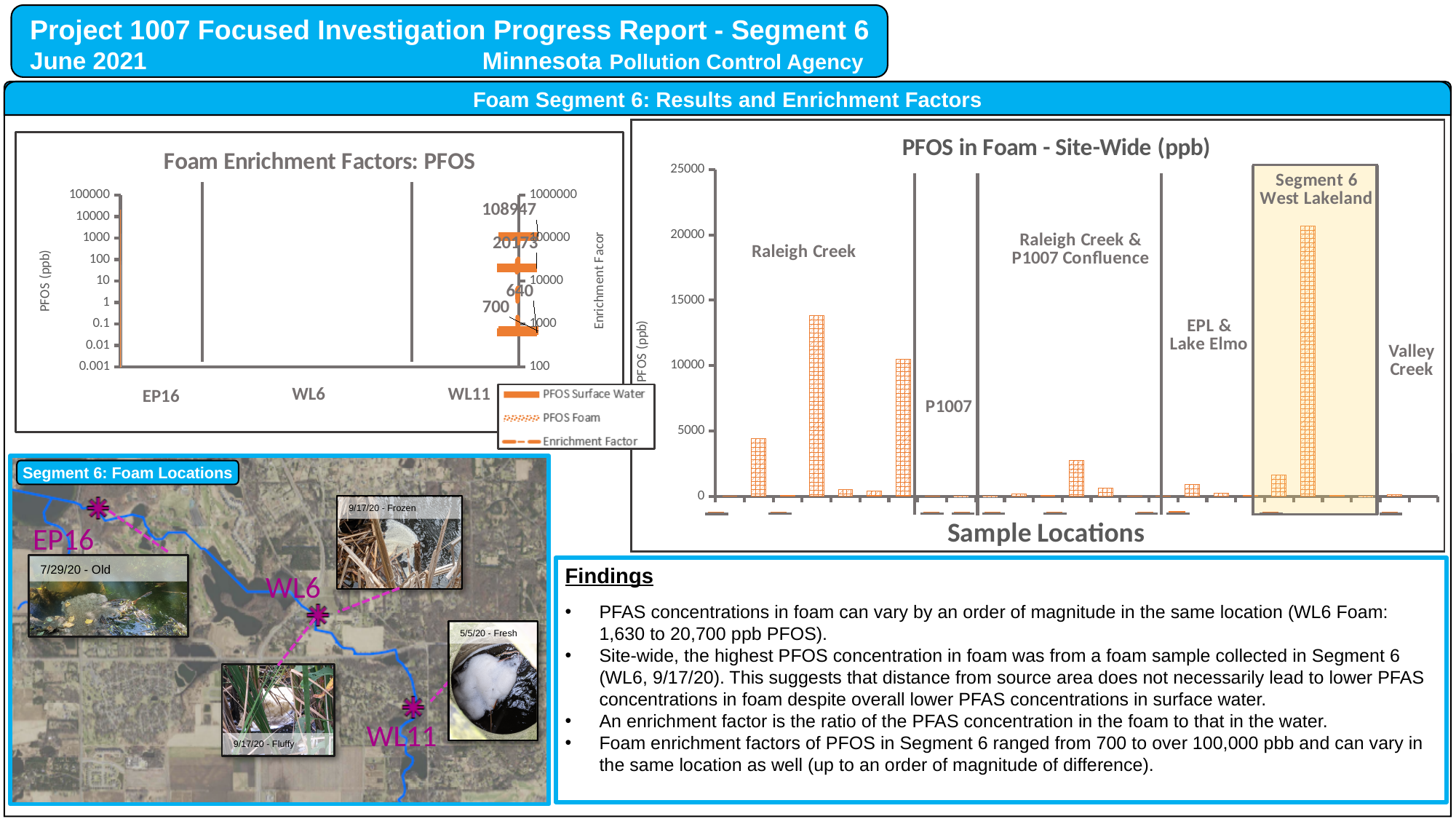
What is the x-axis title of the 'PFOS in Foam - Site-Wide (ppb)' chart? Sample Locations What kind of chart is the 'PFOS in Foam - Site-Wide (ppb)' chart? bar chart In the 'PFOS in Foam - Site-Wide (ppb)' chart, which labelled area contains the tallest bar? Segment 6 West Lakeland In the 'PFOS in Foam - Site-Wide (ppb)' chart, is the tallest bar greater or less than 15000? greater In the 'PFOS in Foam - Site-Wide (ppb)' chart, is the tallest bar in the Raleigh Creek area greater or less than 15000? less How many labelled sample areas are marked on the 'PFOS in Foam - Site-Wide (ppb)' chart? 6 In the 'PFOS in Foam - Site-Wide (ppb)' chart, which area has the taller maximum bar: Raleigh Creek or Raleigh Creek & P1007 Confluence? Raleigh Creek In the 'PFOS in Foam - Site-Wide (ppb)' chart, are the bars in the Valley Creek area greater or less than 5000? less In the 'Foam Enrichment Factors: PFOS' chart, what is the smallest data label shown? 640 How many series does the legend of the 'Foam Enrichment Factors: PFOS' chart list? 3 In the 'Foam Enrichment Factors: PFOS' chart, what is the largest data label shown? 108947 How many sample locations are shown on the x axis of the 'Foam Enrichment Factors: PFOS' chart? 3